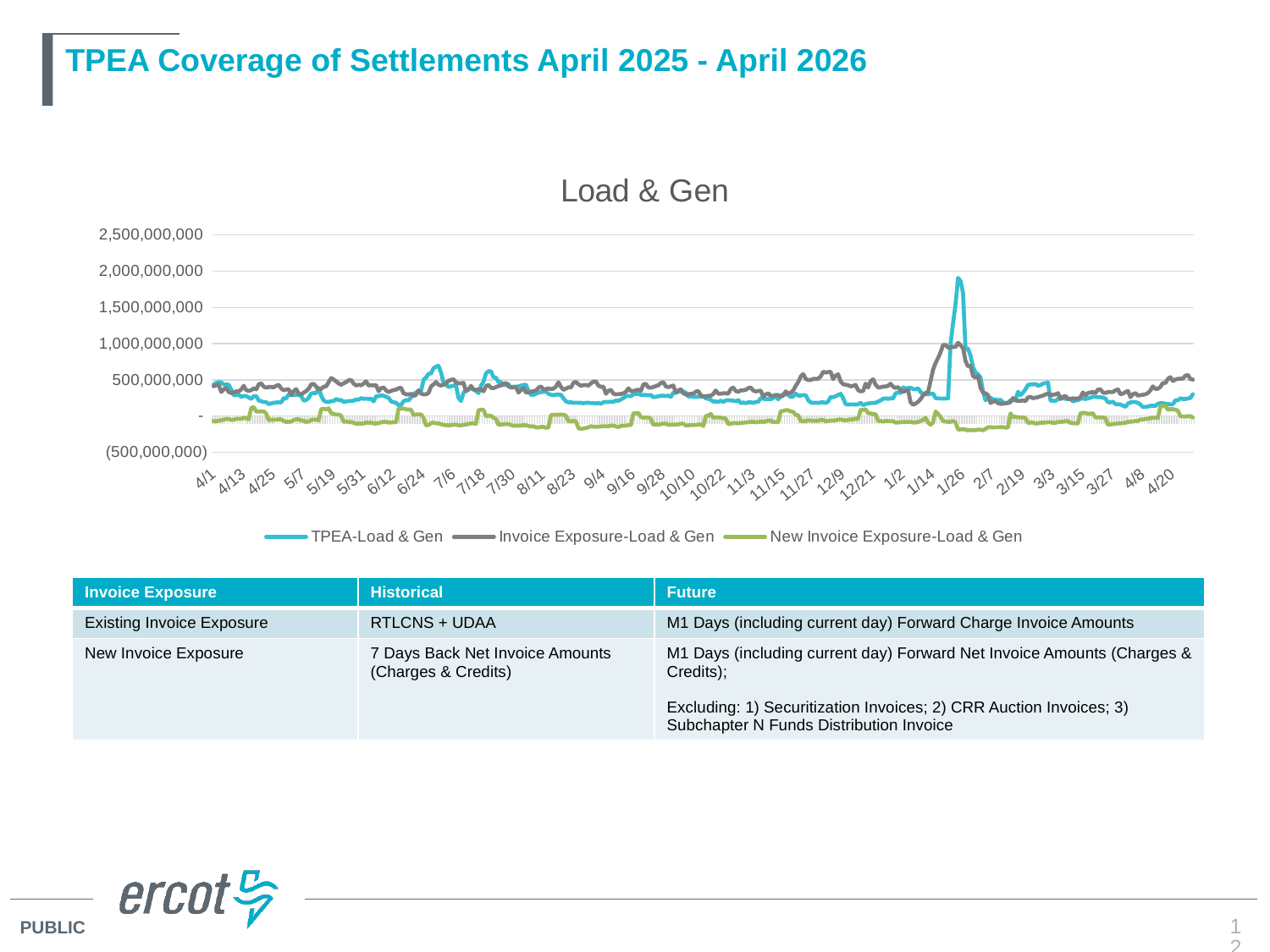
Is the value of the New Invoice Exposure-Load & Gen series on 4/1 greater or less than 500,000,000? less Is the value of the TPEA-Load & Gen series on 4/1 greater or less than 1,000,000,000? less Which series reaches the highest peak on the chart? TPEA-Load & Gen Which series stays lowest across the chart? New Invoice Exposure-Load & Gen At the late-January peak, which series is higher: TPEA-Load & Gen or Invoice Exposure-Load & Gen? TPEA-Load & Gen What is the title of the chart? Load & Gen Is the peak value of the Invoice Exposure-Load & Gen series around late January greater or less than 1,500,000,000? less Which series is drawn in green in the chart? New Invoice Exposure-Load & Gen How many series does the chart legend list? 3 What kind of chart is shown on the slide? line chart What is the highest value shown on the vertical axis? 2,500,000,000